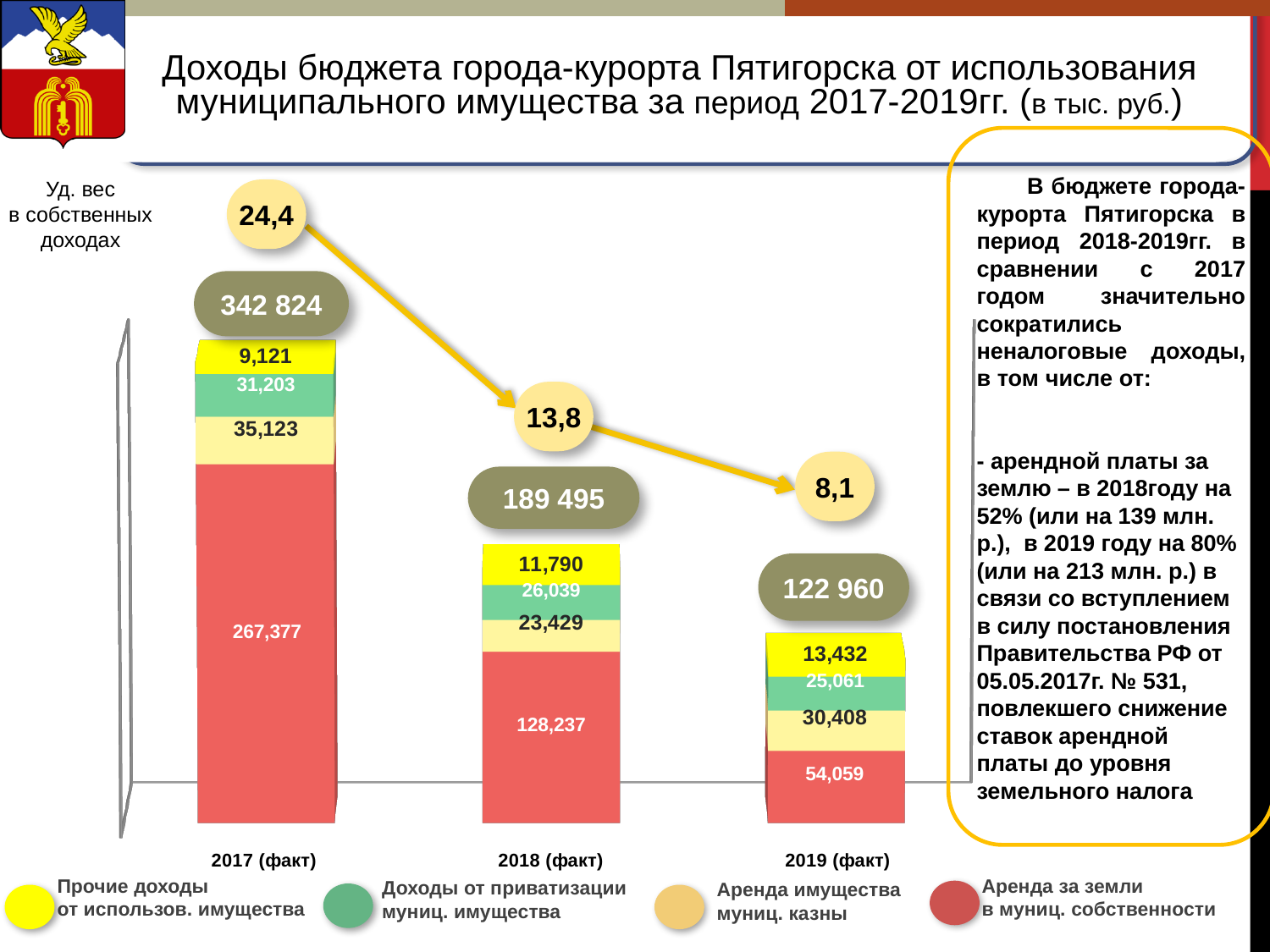
How many years (categories) are shown on the x axis of the chart? 3 What is the value for 'Доходы от приватизации муниц. имущества' in 2018 (факт)? 26,039 How many series does the legend list? 4 Which year has the lowest value for 'Аренда за земли в муниц. собственности'? 2019 (факт) What is the value for 'Аренда за земли в муниц. собственности' in 2017 (факт)? 267,377 Which is larger: 'Аренда имущества муниц. казны' in 2018 (факт) or in 2019 (факт)? 2019 (факт) Which year has the highest total income from municipal property? 2017 (факт) What is the value for 'Прочие доходы от использов. имущества' in 2019 (факт)? 13,432 What type of chart is shown on the slide? stacked bar chart What is the total shown above the stacked bar for 2018 (факт)? 189 495 What is the share in own revenues ('Уд. вес в собственных доходах') shown for 2019? 8,1 What is the difference between the 'Аренда за земли в муниц. собственности' values for 2017 (факт) and 2018 (факт)? 139,140